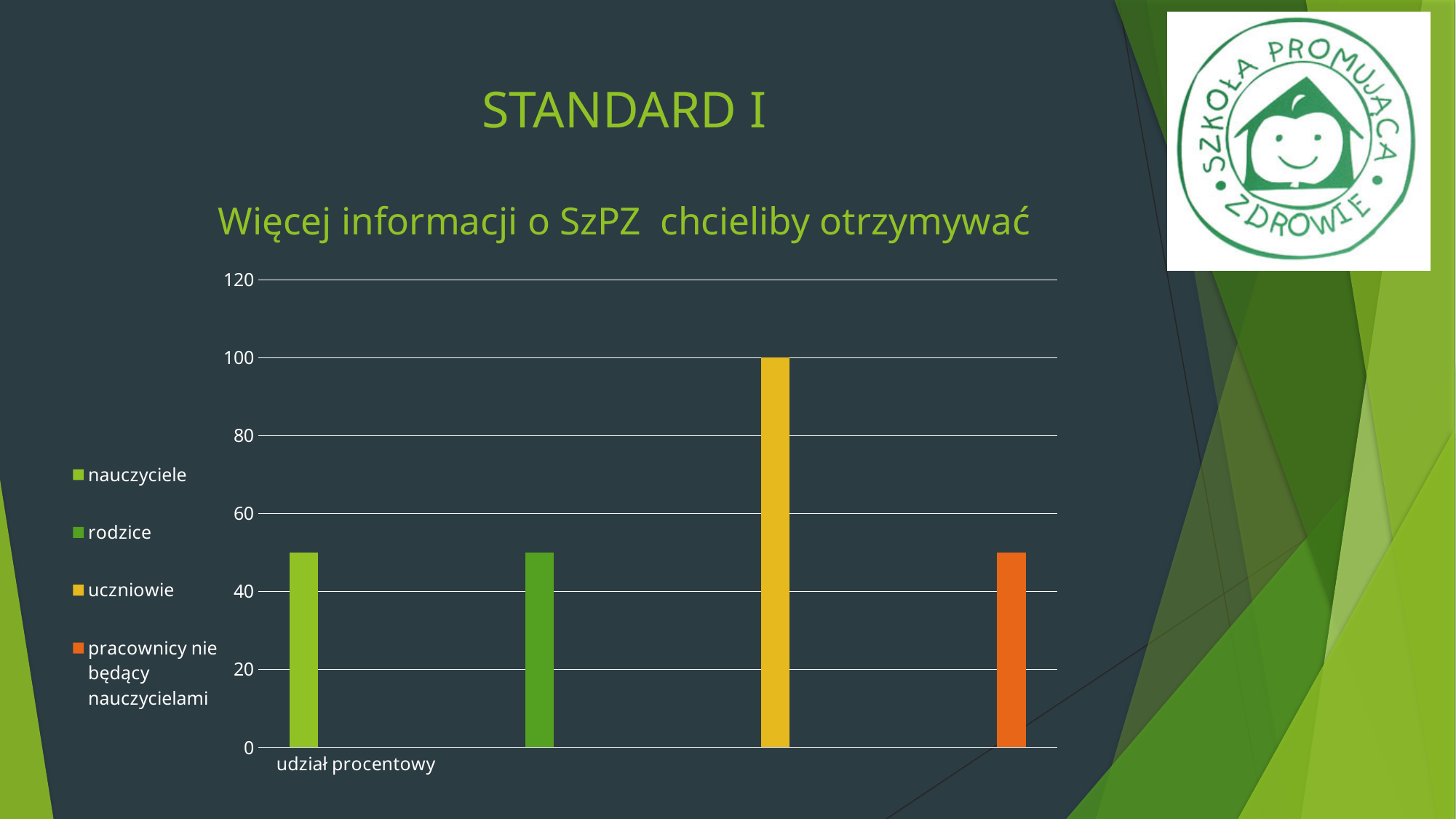
How many series does the legend list? 4 Which is larger, the value for nauczyciele or the value for uczniowie? uczniowie Is the value for rodzice greater or less than 60? less What is the category label shown on the x axis? udział procentowy Is the value for nauczyciele greater or less than 40? greater Is the value for uczniowie greater or less than 80? greater Which is larger, the value for uczniowie or the value for rodzice? uczniowie What is the title of the chart? Więcej informacji o SzPZ chcieliby otrzymywać What is the value for uczniowie? 100 What kind of chart is shown on the slide? bar chart Which series has the highest value? uczniowie